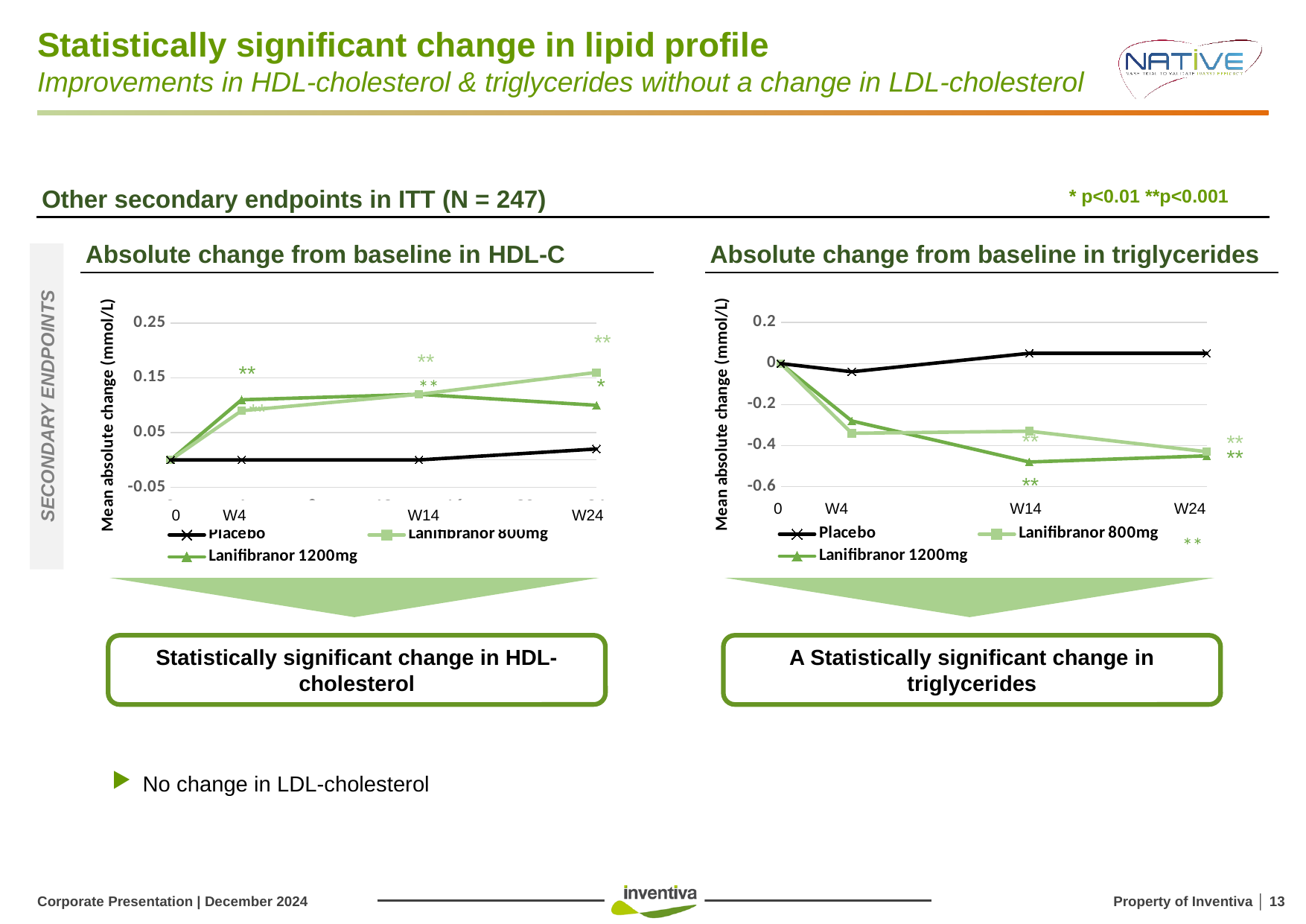
In the 'Absolute change from baseline in triglycerides' chart, which series has the lowest value at W14? Lanifibranor 1200mg How many time points are shown on the x axis of the 'Absolute change from baseline in HDL-C' chart? 4 In the 'Absolute change from baseline in HDL-C' chart, is the Lanifibranor 800mg value at W24 greater or less than 0.05? greater How many series does the legend of the 'Absolute change from baseline in triglycerides' chart list? 3 In the 'Absolute change from baseline in triglycerides' chart, what is the Placebo value at time 0? 0 In the 'Absolute change from baseline in HDL-C' chart, which series has the highest value at W24? Lanifibranor 800mg In the 'Absolute change from baseline in HDL-C' chart, is the Placebo value at W24 greater or less than 0.05? less In the 'Absolute change from baseline in triglycerides' chart, does the Lanifibranor 1200mg line rise or fall from 0 to W14? fall In the 'Absolute change from baseline in triglycerides' chart, which is larger at W24: Placebo or Lanifibranor 800mg? Placebo What kind of chart is 'Absolute change from baseline in HDL-C'? line chart In the 'Absolute change from baseline in triglycerides' chart, is the Lanifibranor 1200mg value at W14 greater or less than -0.4? less What is the y-axis label of the 'Absolute change from baseline in HDL-C' chart? Mean absolute change (mmol/L)